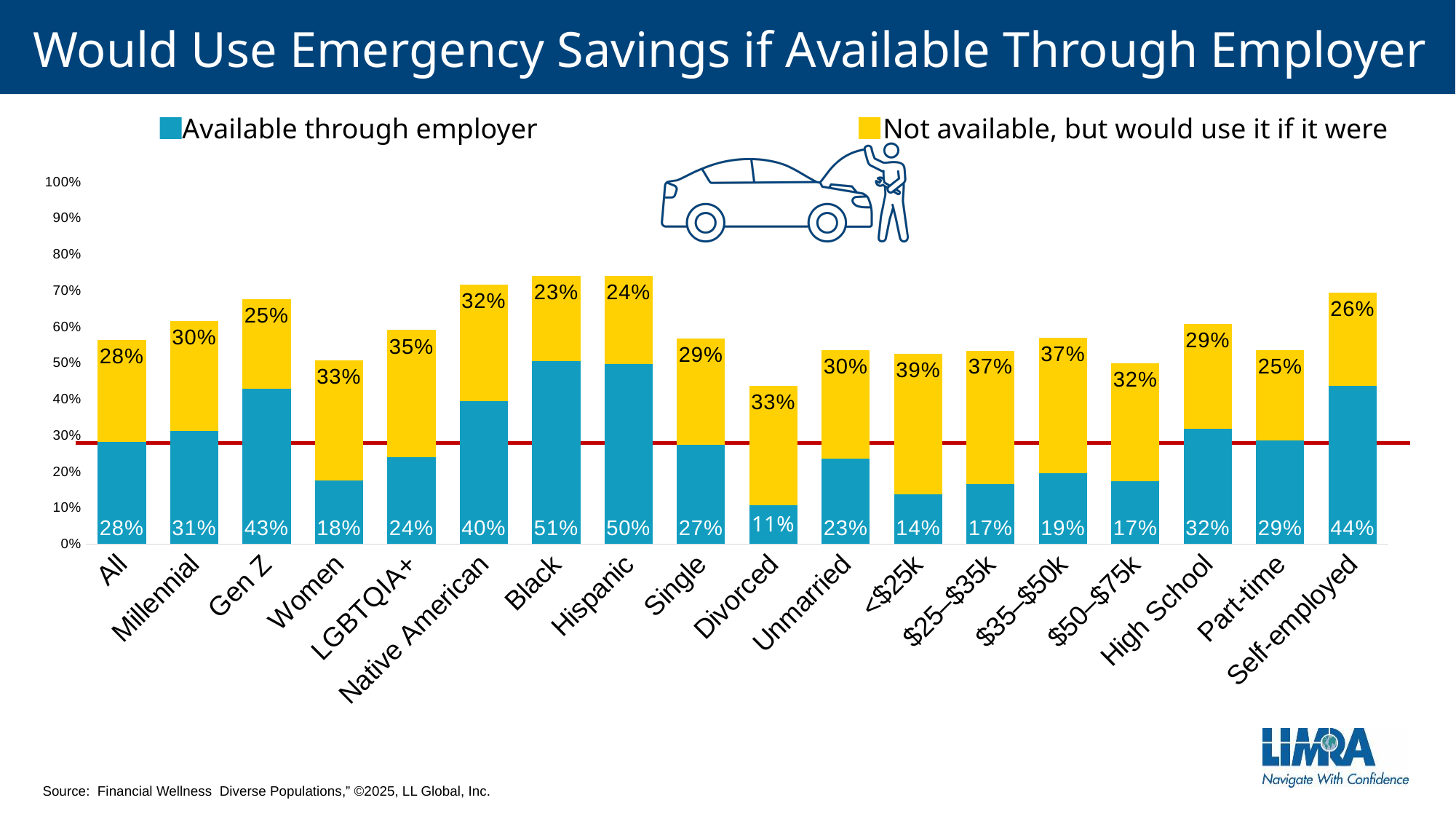
Which category has the lowest value for 'Available through employer'? Divorced What is the total of the stacked bar for Divorced? 44% Which is larger: the 'Available through employer' value for Self-employed or for Native American? Self-employed How many series does the legend list? 2 How many categories are shown on the x axis? 18 What type of chart is shown on the slide? Stacked bar chart What percentage of Black respondents have emergency savings available through their employer? 51% Which category has the highest value for 'Available through employer'? Black What is the difference between the 'Available through employer' values for Gen Z and Women? 25% What is the total of the stacked bar for Hispanic? 74% What is the value for Women in the 'Not available, but would use it if it were' series? 33% Which category has the highest value for 'Not available, but would use it if it were'? <$25k